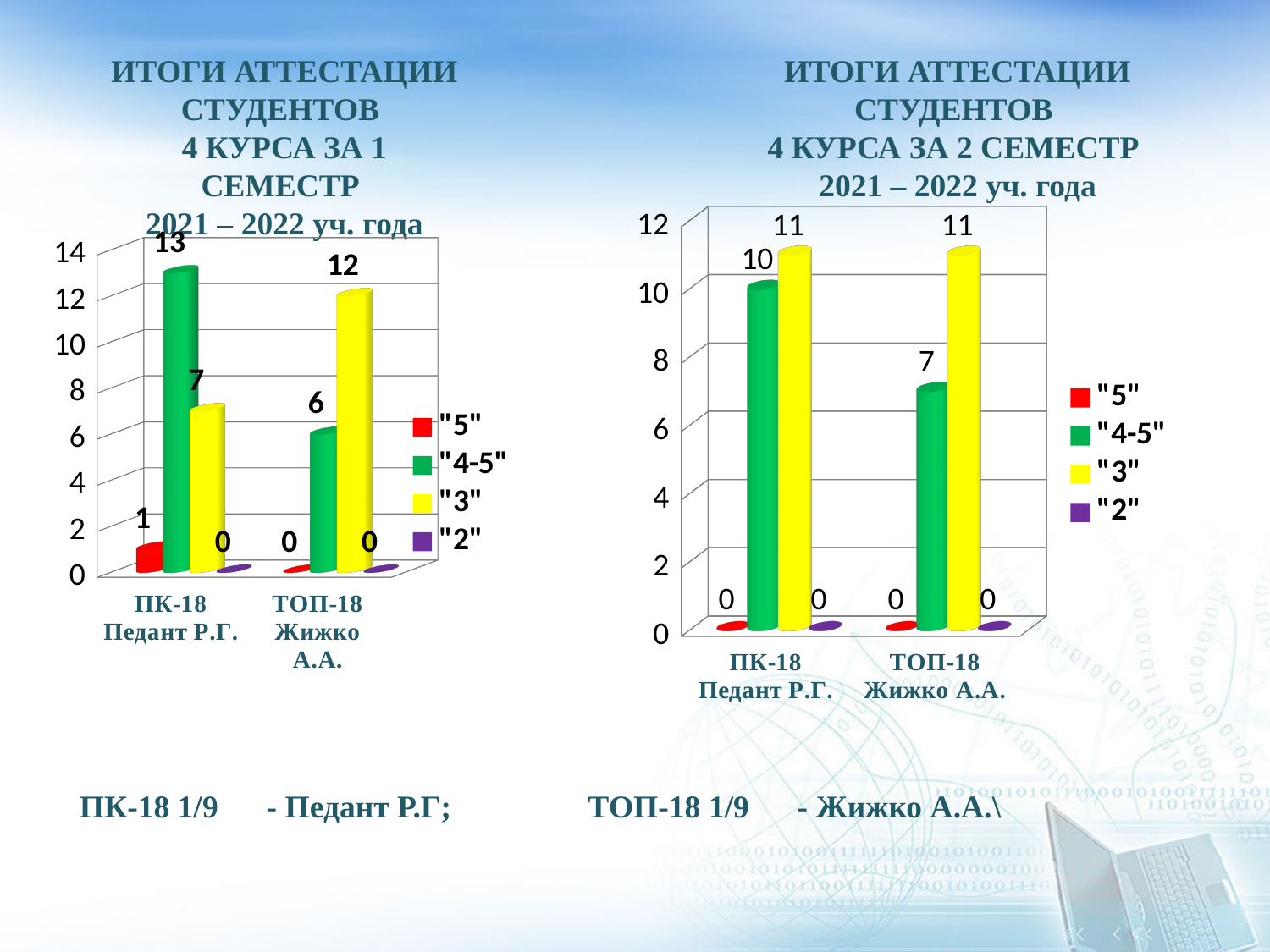
How many series does the legend of the right chart (2 семестр) list? 4 In the right chart (2 семестр), what is the value of "3" for ПК-18 Педант Р.Г.? 11 In the right chart (2 семестр), which group has the larger "4-5" value, ПК-18 Педант Р.Г. or ТОП-18 Жижко А.А.? ПК-18 Педант Р.Г. In the left chart (1 семестр), what is the value of "5" for ПК-18 Педант Р.Г.? 1 In the left chart (1 семестр), what is the value of "3" for ТОП-18 Жижко А.А.? 12 In the right chart (2 семестр), what is the value of "4-5" for ТОП-18 Жижко А.А.? 7 In the left chart (1 семестр), what is the difference between "4-5" and "3" for ПК-18 Педант Р.Г.? 6 In the left chart (1 семестр), which series has the highest value for ТОП-18 Жижко А.А.? "3" In the left chart (1 семестр), what is the value of "4-5" for ПК-18 Педант Р.Г.? 13 What type of chart is the right chart (2 семестр)? Bar chart In the right chart (2 семестр), what is the difference between "3" and "4-5" for ТОП-18 Жижко А.А.? 4 How many groups (categories) are shown on the x axis of the left chart (1 семестр)? 2